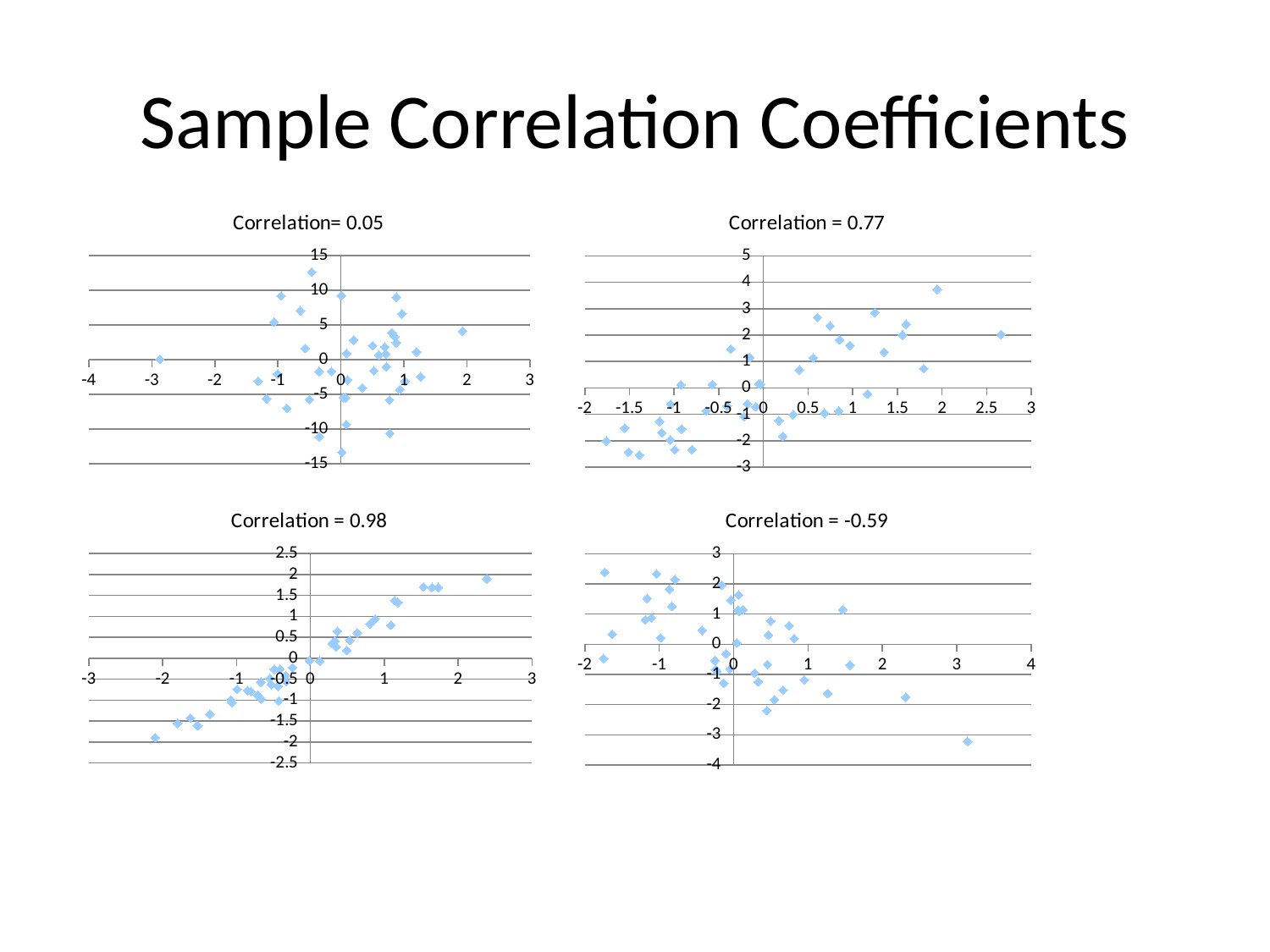
What is the title of the top-left chart? Correlation= 0.05 In the 'Correlation = 0.77' chart, do the points generally rise or fall as x increases? rise In the 'Correlation = -0.59' chart, do the points generally rise or fall as x increases? fall In the 'Correlation = 0.77' chart, is the y value of the highest point greater or less than 3? greater How many charts are shown on the slide? 4 What kind of chart is the 'Correlation = 0.98' chart? scatter chart Which chart's title shows the highest correlation value? Correlation = 0.98 In the 'Correlation = 0.98' chart, is the y value of the leftmost point greater or less than -1.5? less In the 'Correlation = 0.98' chart, do the points generally rise or fall as x increases? rise In the 'Correlation = 0.98' chart, is the y value of the rightmost point greater or less than 1.5? greater